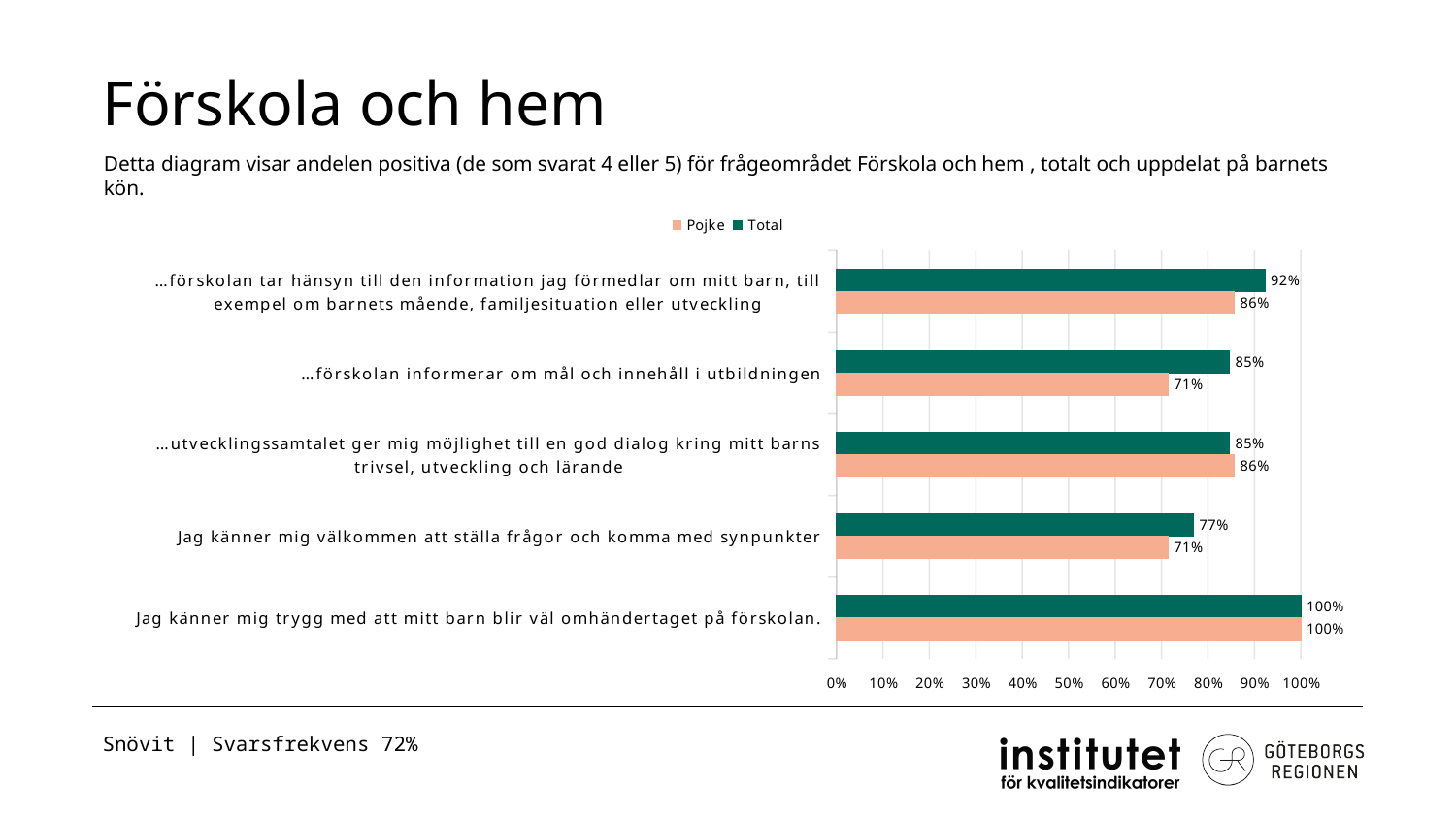
Which series is shown in green in the chart? Total Which statement has the lowest Total value? Jag känner mig välkommen att ställa frågor och komma med synpunkter What is the Pojke value for "Jag känner mig trygg med att mitt barn blir väl omhändertaget på förskolan."? 100% How many statements (categories) are plotted in the chart? 5 What is the Pojke value for "…förskolan informerar om mål och innehåll i utbildningen"? 71% Which statement has the highest Total value? Jag känner mig trygg med att mitt barn blir väl omhändertaget på förskolan. For "…förskolan tar hänsyn till den information jag förmedlar om mitt barn, till exempel om barnets mående, familjesituation eller utveckling", which is larger, the Total value or the Pojke value? Total What kind of chart is shown on the slide? bar chart What is the Total value for "Jag känner mig välkommen att ställa frågor och komma med synpunkter"? 77% What is the difference between the Total and Pojke values for "…förskolan informerar om mål och innehåll i utbildningen"? 14 percentage points What is the Total value for "…förskolan tar hänsyn till den information jag förmedlar om mitt barn, till exempel om barnets mående, familjesituation eller utveckling"? 92% How many series does the legend list? 2